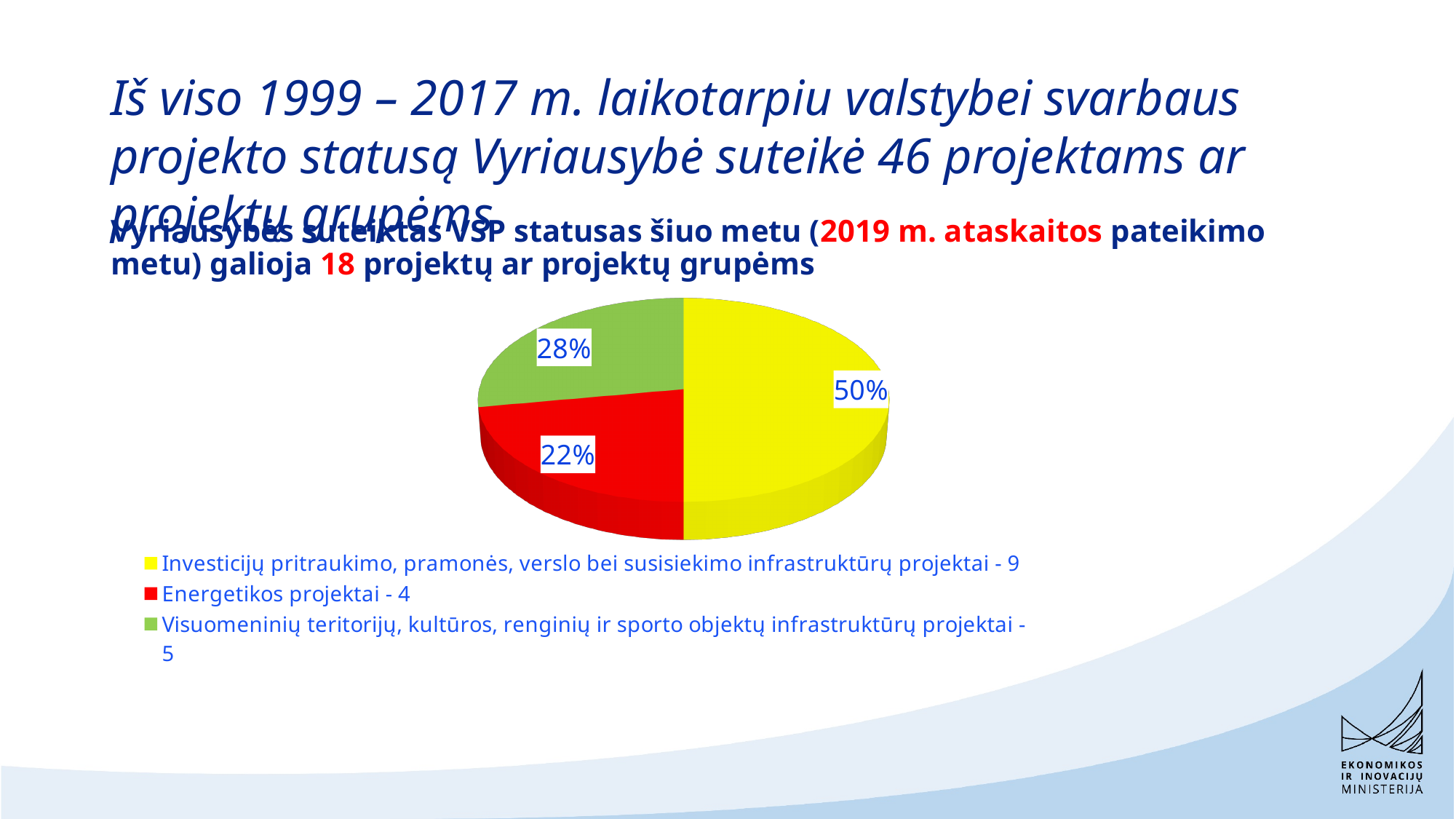
How many entries does the legend of the pie chart list? 3 What percentage share does the slice for "Energetikos projektai" have? 22% Which category has the largest slice of the pie chart? Investicijų pritraukimo, pramonės, verslo bei susisiekimo infrastruktūrų projektai What is the difference in percentage points between the largest slice (50%) and the "Energetikos projektai" slice (22%)? 28 What colour is the slice for "Energetikos projektai" in the pie chart? red Which category has the smallest slice of the pie chart? Energetikos projektai What percentage share does the slice for "Investicijų pritraukimo, pramonės, verslo bei susisiekimo infrastruktūrų projektai" have? 50% What kind of chart is shown on the slide? pie chart What percentage share does the slice for "Visuomeninių teritorijų, kultūros, renginių ir sporto objektų infrastruktūrų projektai" have? 28% How many projects does the legend give for "Energetikos projektai"? 4 Which slice is larger: "Energetikos projektai" or "Visuomeninių teritorijų, kultūros, renginių ir sporto objektų infrastruktūrų projektai"? Visuomeninių teritorijų, kultūros, renginių ir sporto objektų infrastruktūrų projektai How many slices does the pie chart have? 3